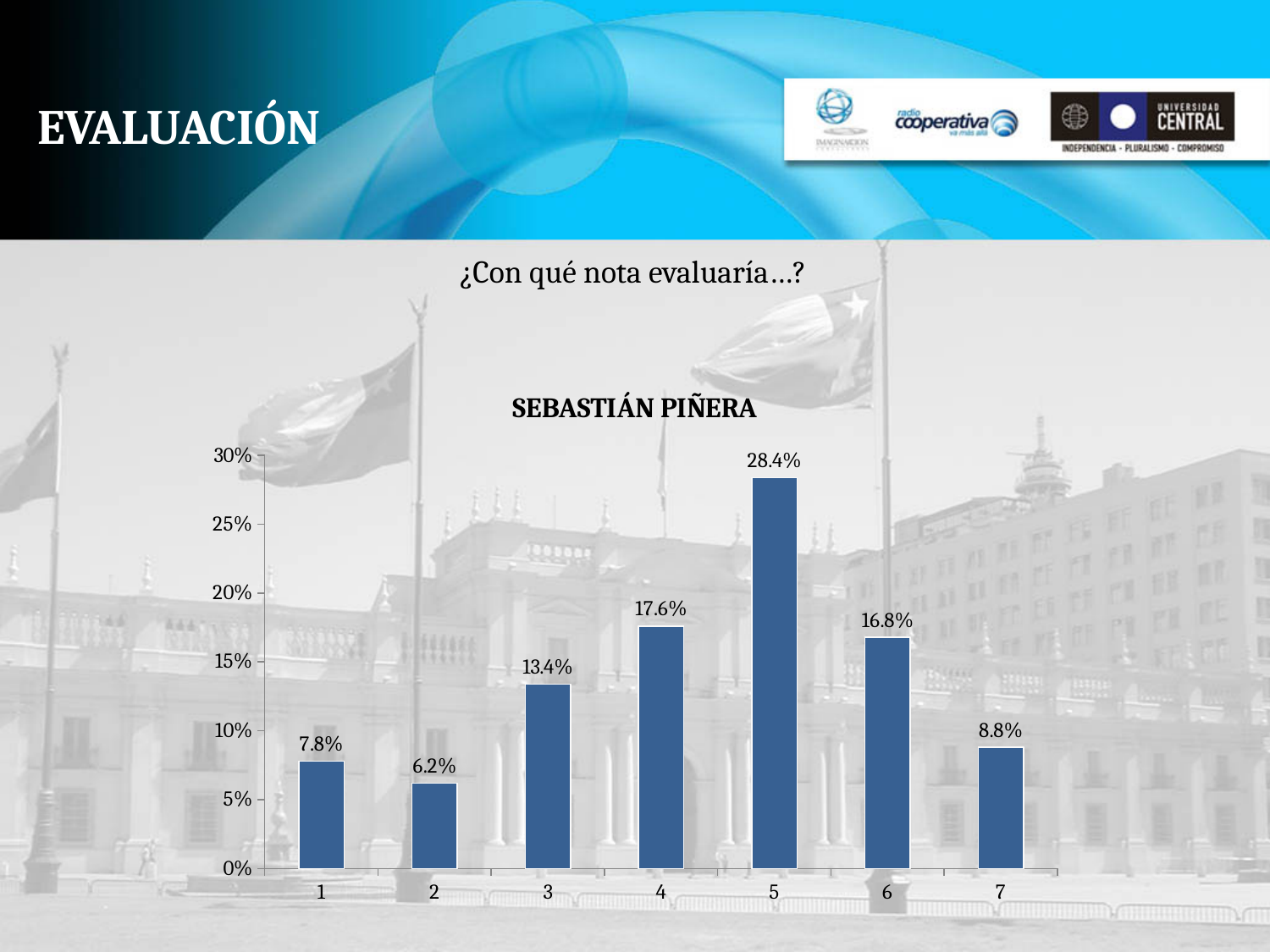
Which is larger, the value for grade 4 or the value for grade 6? grade 4 Do the values rise or fall from grade 5 to grade 7? fall How many grade categories are shown on the x axis? 7 Which grade has the highest percentage? 5 What kind of chart is shown on the slide? bar chart What is the value shown for grade 1? 7.8% What is the title of the chart? SEBASTIÁN PIÑERA Which grade has the lowest percentage? 2 What is the value shown for grade 7? 8.8% Is the value for grade 3 greater or less than 15%? less What is the difference between the values for grade 5 and grade 4? 10.8% What percentage of respondents gave Sebastián Piñera a grade of 5? 28.4%